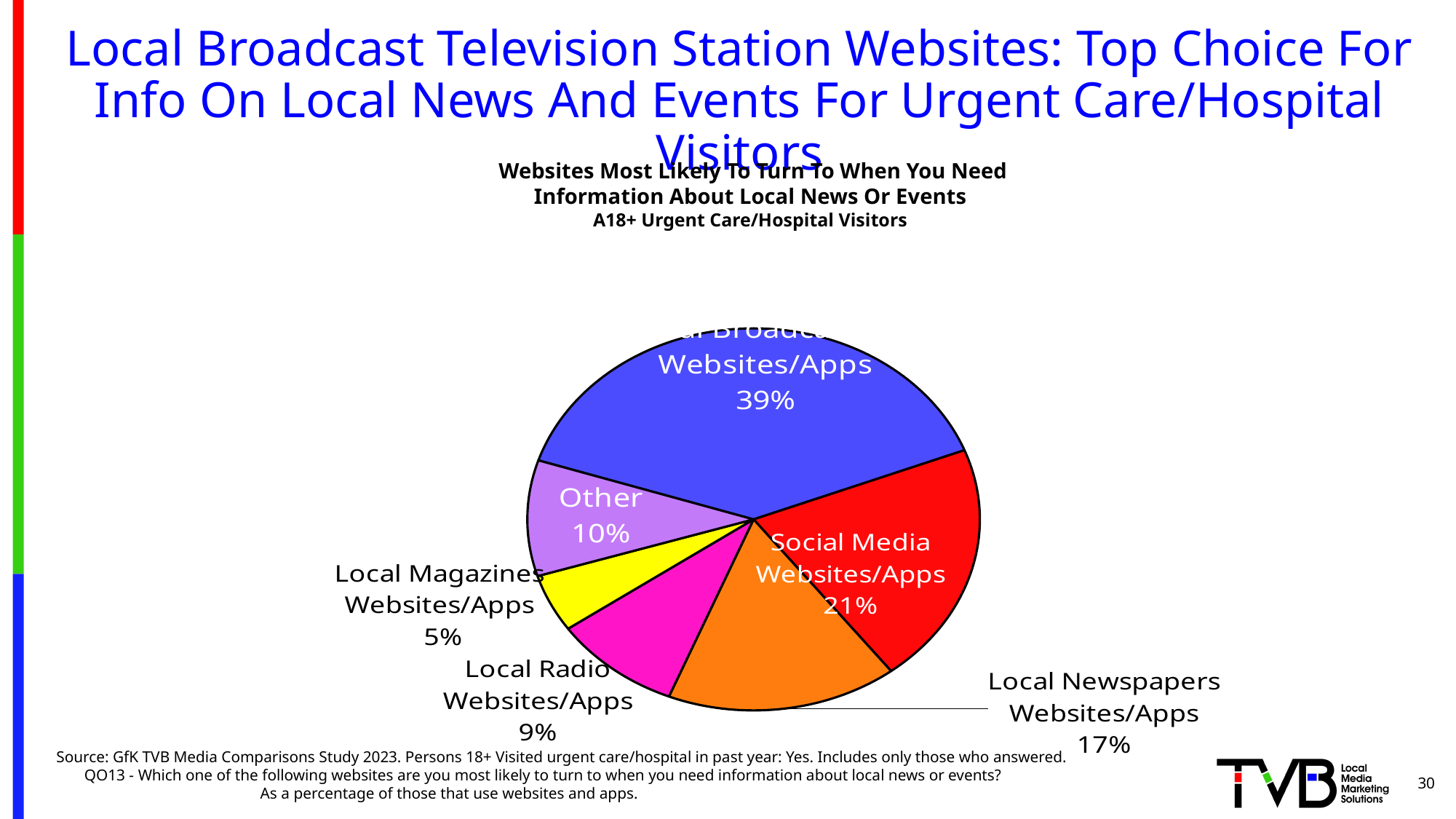
What percentage is shown for the Other slice? 10% What percentage is shown for Local Magazines Websites/Apps? 5% How many slices does the pie chart have? 6 What percentage of A18+ urgent care/hospital visitors turn to Social Media Websites/Apps for local news or events? 21% What percentage is shown on the largest (blue) slice of the pie? 39% What is the difference in percentage points between Social Media Websites/Apps and Local Newspapers Websites/Apps? 4 Which category has the smallest slice of the pie? Local Magazines Websites/Apps What share of the pie is Local Newspapers Websites/Apps? 17% What type of chart is shown on the slide? pie chart Which is larger: Local Radio Websites/Apps or Other? Other What percentage is shown for Local Radio Websites/Apps? 9% What colour is the Social Media Websites/Apps slice? red